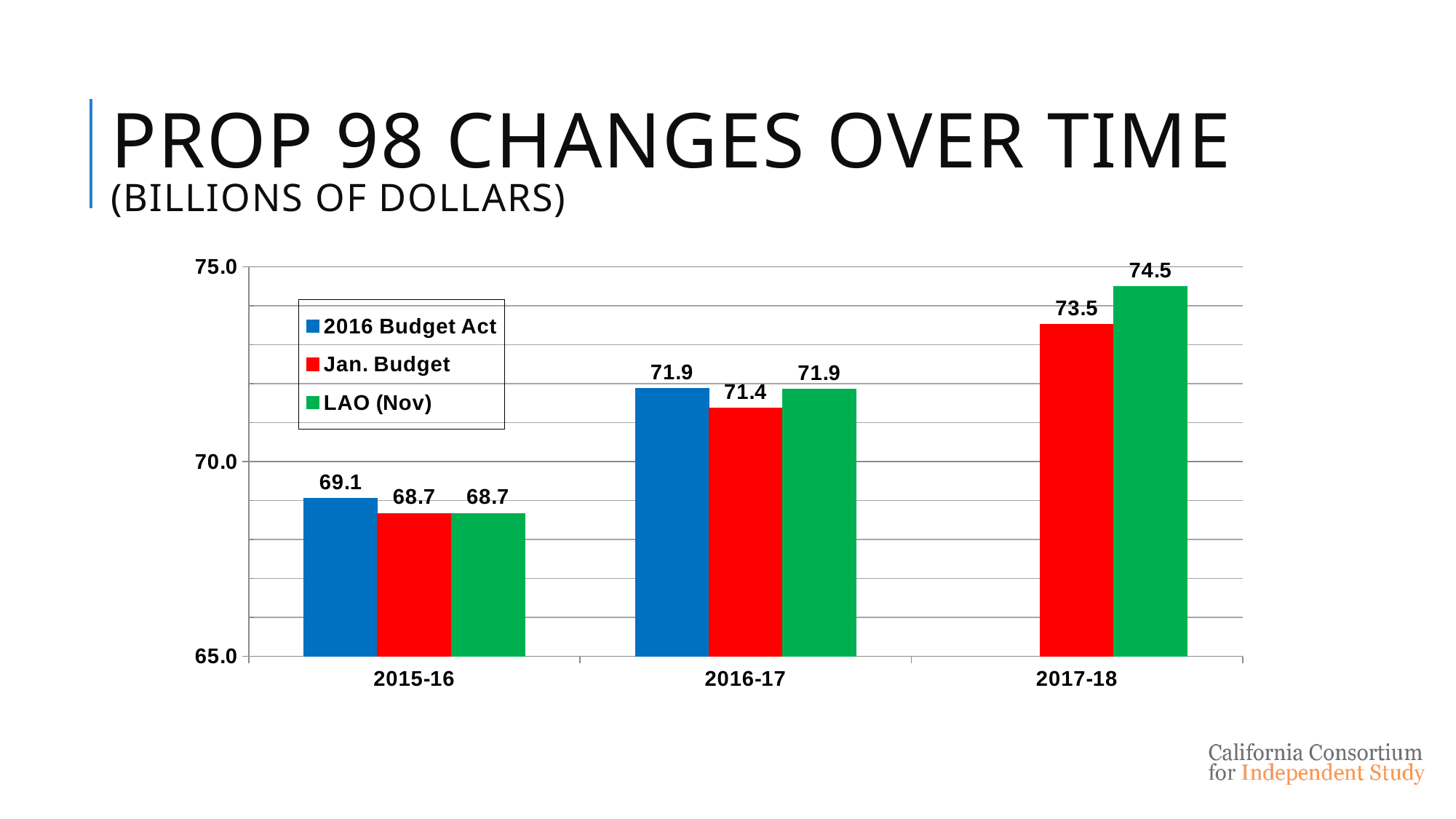
Which year has the lowest Jan. Budget value? 2015-16 Which year has the highest LAO (Nov) value? 2017-18 Do the Jan. Budget values rise or fall from 2015-16 to 2017-18? Rise What kind of chart is shown on the slide? Bar chart What is the difference between the 2016 Budget Act and Jan. Budget values in 2016-17? 0.5 How many year categories are shown on the x axis? 3 What is the value for the 2016 Budget Act series in 2015-16? 69.1 What is the value for the LAO (Nov) series in 2016-17? 71.9 What is the difference between the LAO (Nov) and Jan. Budget values in 2017-18? 1.0 How many series does the legend list? 3 What is the value for the Jan. Budget series in 2017-18? 73.5 Which is larger in 2015-16, the 2016 Budget Act value or the Jan. Budget value? 2016 Budget Act